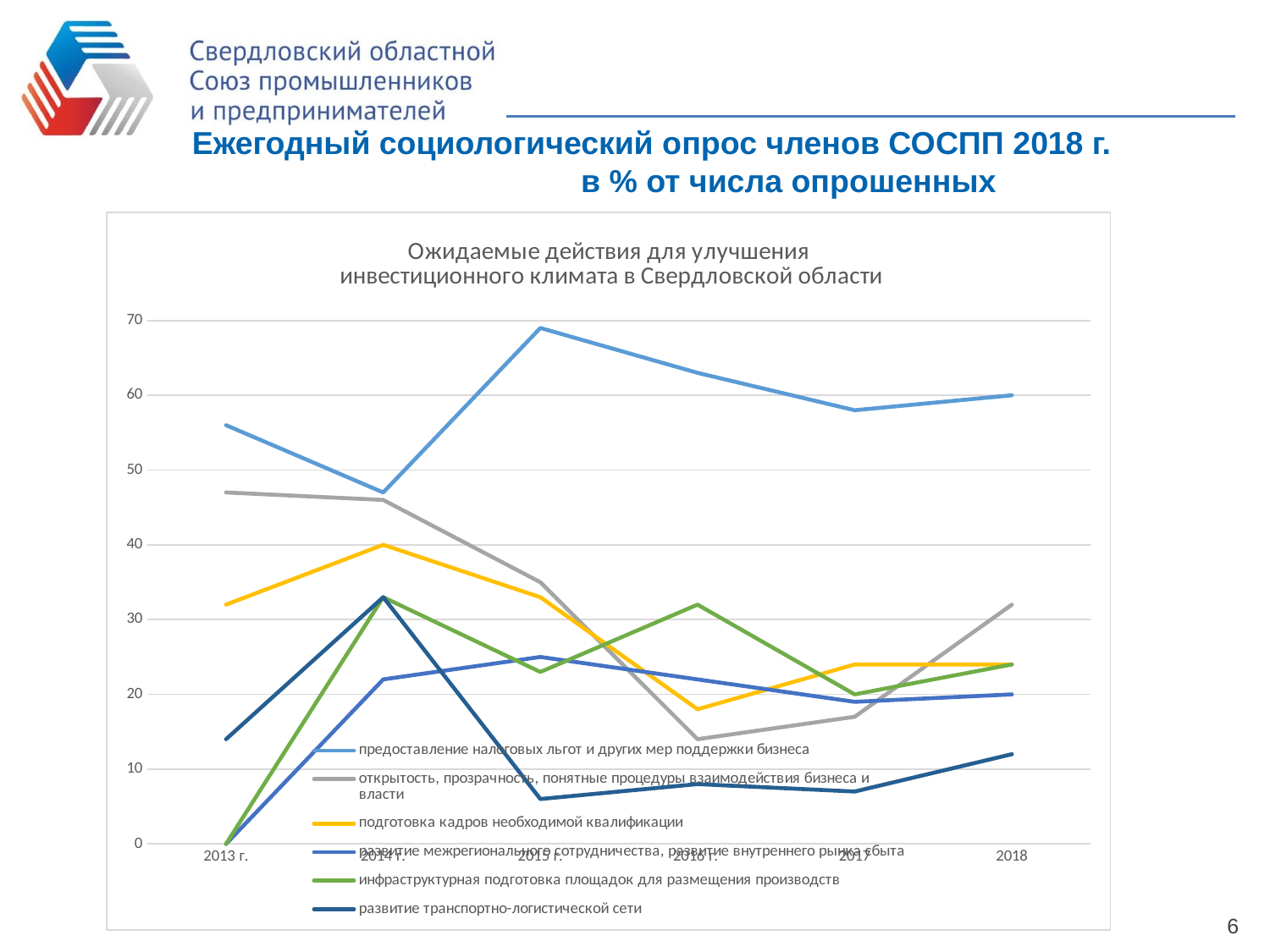
In which year does the series 'предоставление налоговых льгот и других мер поддержки бизнеса' reach its highest value? 2015 г. What kind of chart is shown on the slide? line chart In which year does the series 'предоставление налоговых льгот и других мер поддержки бизнеса' have its lowest value? 2014 г. Is the 2015 value for 'развитие транспортно-логистической сети' greater or less than 10? less Is the 2016 value for 'открытость, прозрачность, понятные процедуры взаимодействия бизнеса и власти' greater or less than 20? less How many series does the chart legend list? 6 In 2013, which is higher: 'открытость, прозрачность, понятные процедуры взаимодействия бизнеса и власти' or 'подготовка кадров необходимой квалификации'? открытость, прозрачность, понятные процедуры взаимодействия бизнеса и власти What is the title of the chart? Ожидаемые действия для улучшения инвестиционного климата в Свердловской области Does the series 'развитие транспортно-логистической сети' rise or fall from 2015 to 2018? rise Is the 2015 value for 'предоставление налоговых льгот и других мер поддержки бизнеса' greater or less than 60? greater How many years are shown along the x axis of the chart? 6 What is the 2013 value for 'инфраструктурная подготовка площадок для размещения производств'? 0